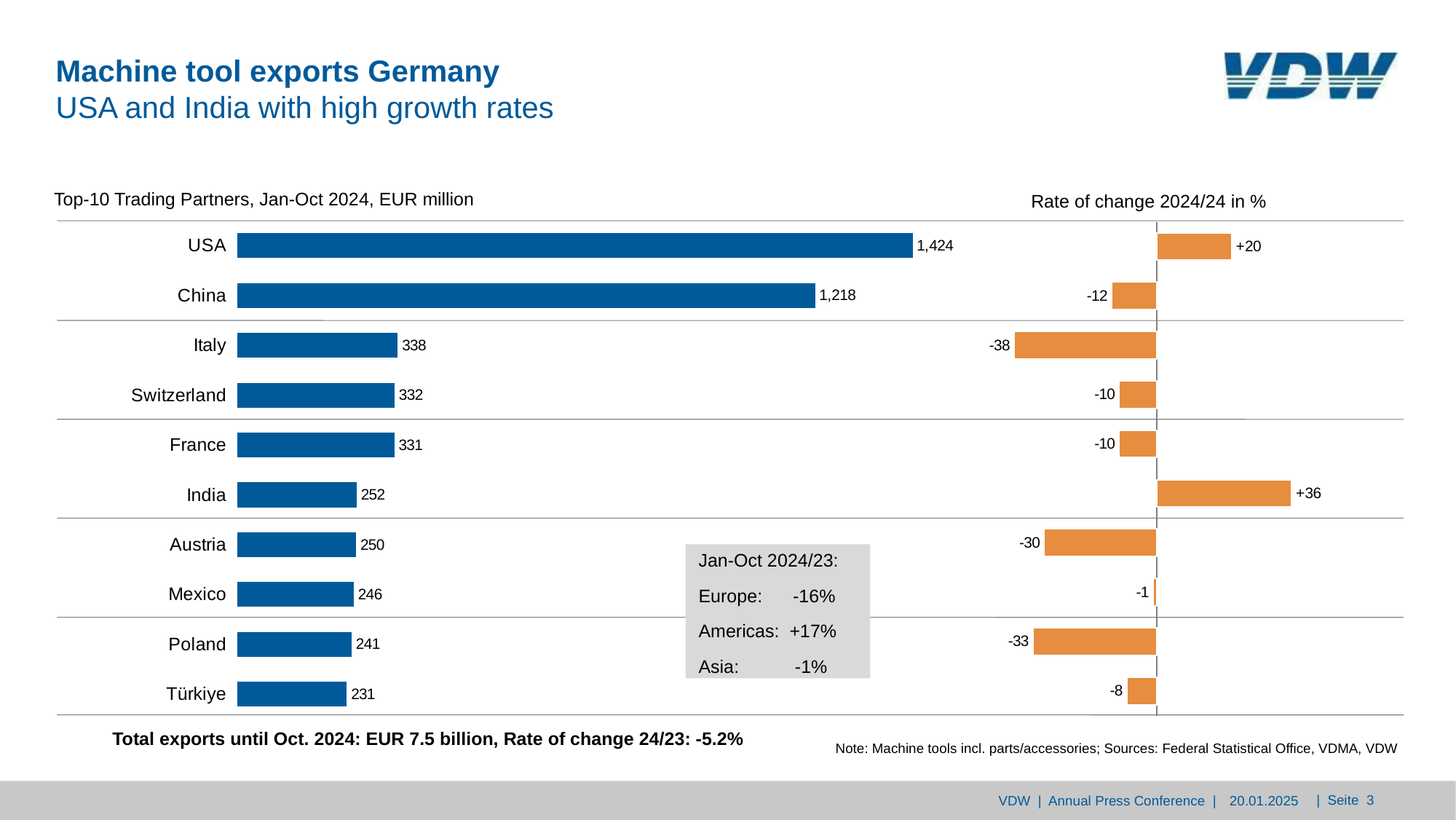
In the 'Top-10 Trading Partners, Jan-Oct 2024, EUR million' chart, which country has the lowest export value? Türkiye In the 'Rate of change 2024/24 in %' chart, which country has the highest rate of change? India In the 'Top-10 Trading Partners, Jan-Oct 2024, EUR million' chart, what is the difference between the values for USA and China? 206 In the 'Top-10 Trading Partners, Jan-Oct 2024, EUR million' chart, what is the value for China? 1,218 In the 'Rate of change 2024/24 in %' chart, what is the value for Poland? -33 In the 'Rate of change 2024/24 in %' chart, which country has the lowest rate of change? Italy What kind of chart is the 'Top-10 Trading Partners, Jan-Oct 2024, EUR million' chart? Bar chart In the 'Top-10 Trading Partners, Jan-Oct 2024, EUR million' chart, how many countries are shown? 10 In the 'Top-10 Trading Partners, Jan-Oct 2024, EUR million' chart, what is the value for Austria? 250 In the 'Rate of change 2024/24 in %' chart, what is the value for India? +36 In the 'Top-10 Trading Partners, Jan-Oct 2024, EUR million' chart, which country has the highest export value? USA In the 'Rate of change 2024/24 in %' chart, which is larger, the value for USA or the value for India? India